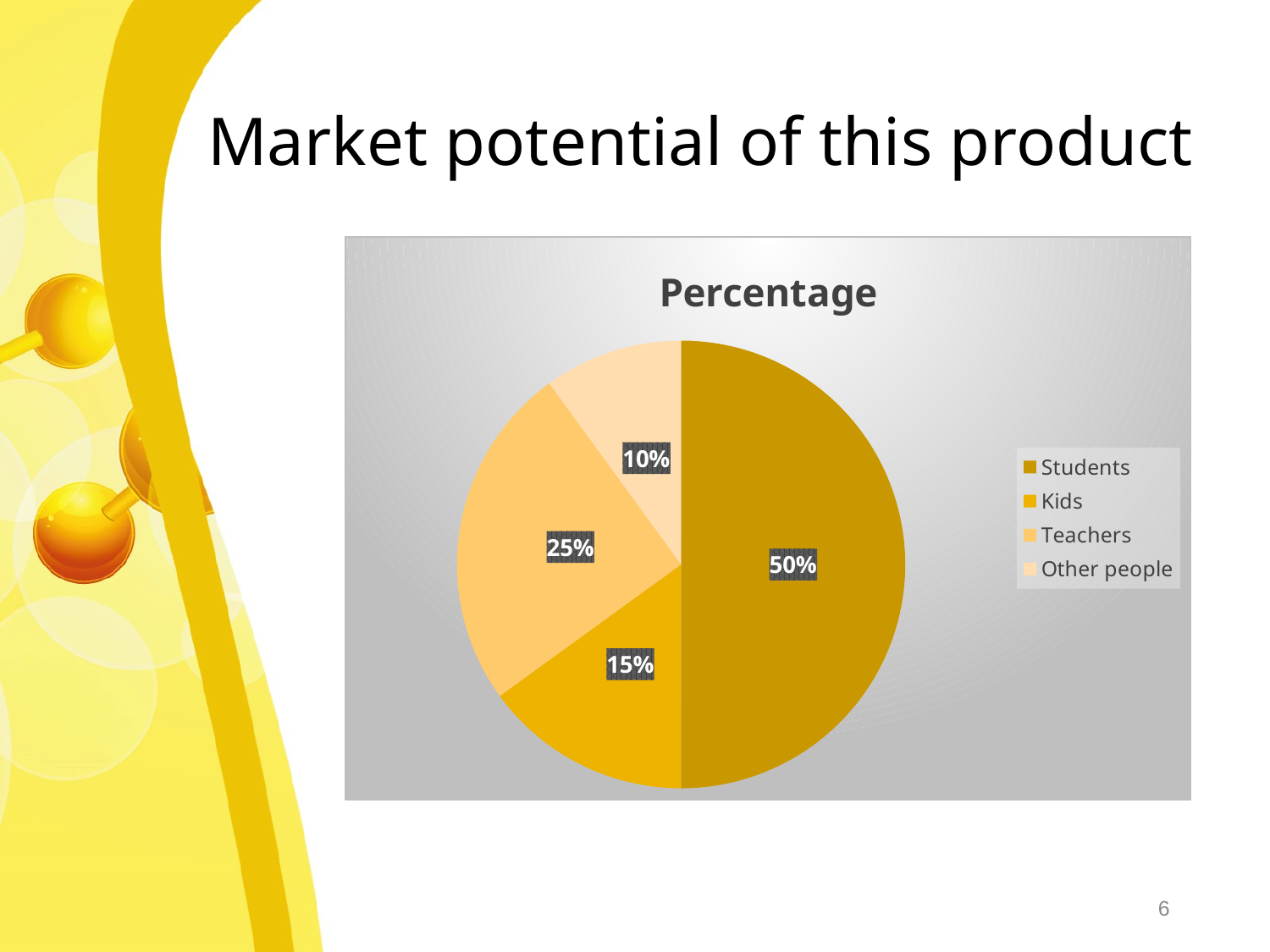
What type of chart is shown on the slide? Pie chart What percentage of the pie is Teachers? 25% Which category has the largest share of the pie? Students What percentage of the pie is Kids? 15% Which is larger, the share for Kids or the share for Teachers? Teachers Which category has the smallest share of the pie? Other people What is the difference in percentage points between Students and Teachers? 25 What percentage of the pie is Students? 50% What is the title of the chart? Percentage How many entries are listed in the legend? 4 How many categories does the pie chart have? 4 What percentage of the pie is Other people? 10%